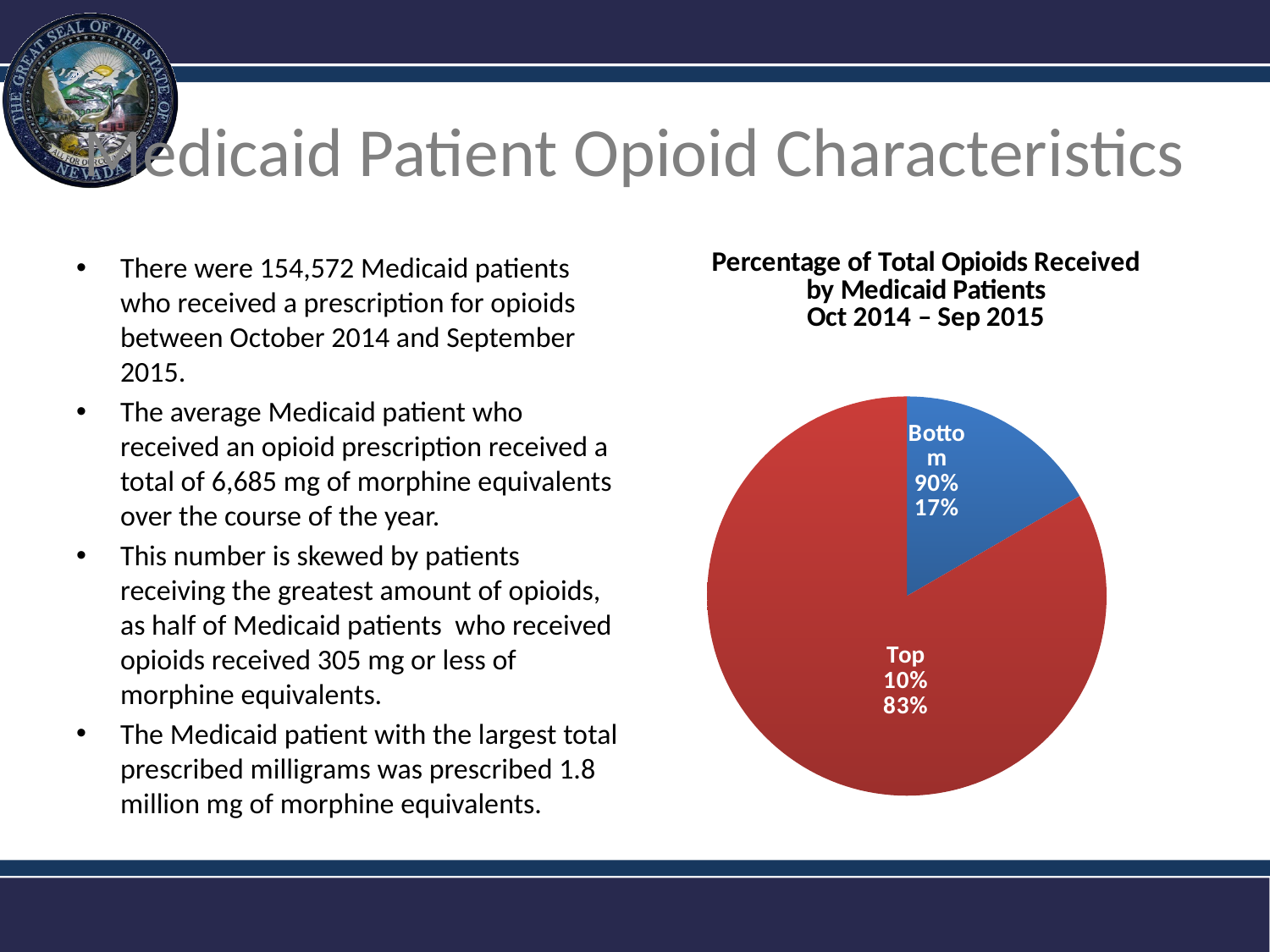
What percentage of total opioids was received by the Top 10% of Medicaid patients? 83% What is the difference in percentage points between the Top 10% slice and the Bottom 90% slice? 66 Which slice of the pie is the largest? Top 10% What is the total of the two slice percentages shown on the pie? 100% Which slice of the pie is the smallest? Bottom 90% What kind of chart is shown on the slide? pie chart How many slices does the pie chart have? 2 Which slice is larger, Top 10% or Bottom 90%? Top 10% What percentage of total opioids was received by the Bottom 90% of Medicaid patients? 17% What colour is the Top 10% slice? red What is the title of the chart? Percentage of Total Opioids Received by Medicaid Patients Oct 2014 – Sep 2015